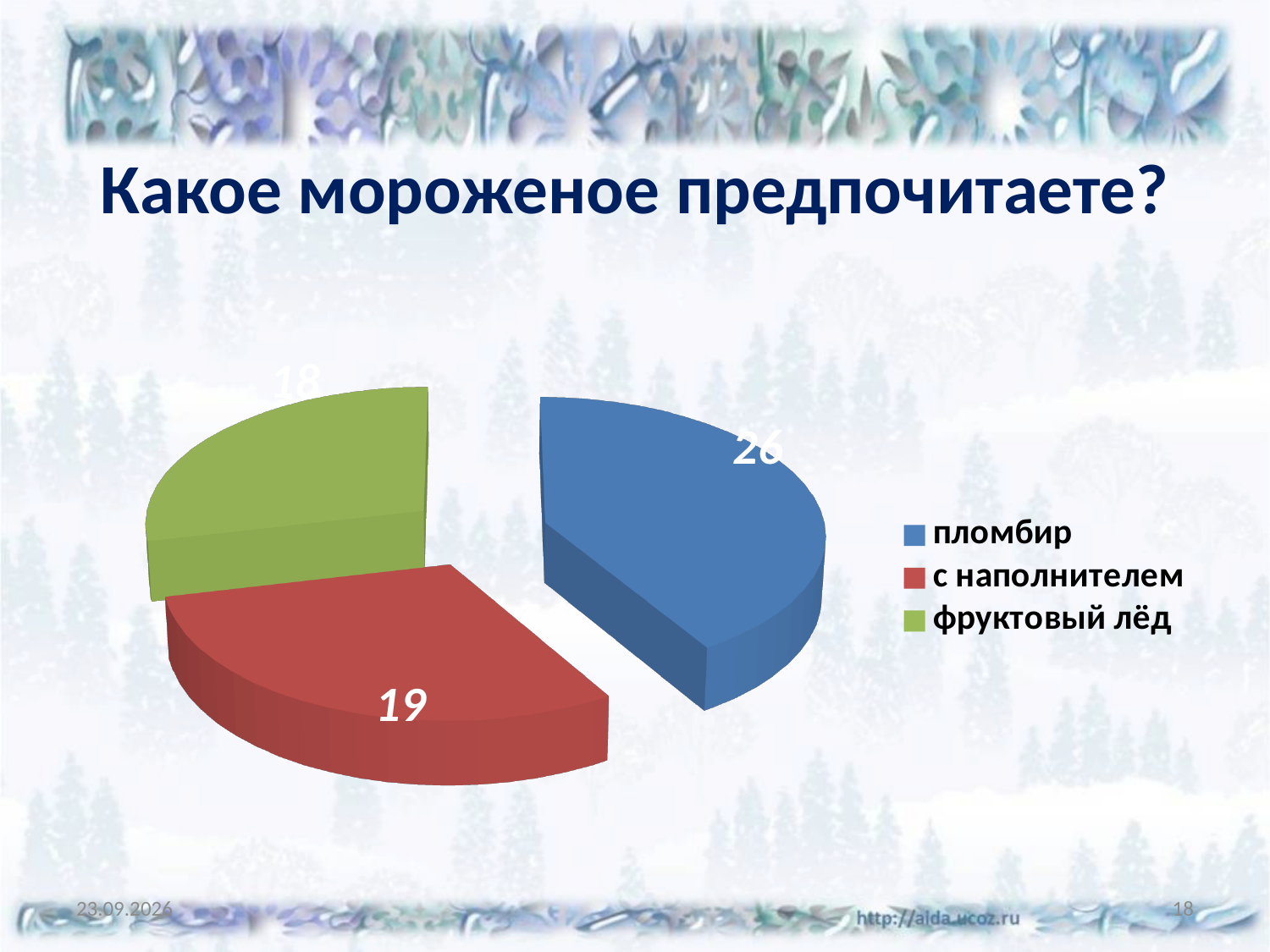
What is the value for фруктовый лёд in the pie chart? 18 What is the difference between the values for с наполнителем and фруктовый лёд? 1 Which is larger, the value for пломбир or the value for с наполнителем? пломбир What is the value for с наполнителем in the pie chart? 19 What is the value for пломбир in the pie chart? 26 What is the difference between the values for пломбир and фруктовый лёд? 8 What kind of chart is shown on the slide? pie chart How many categories are shown in the pie chart? 3 Which category has the largest slice in the pie chart? пломбир What is the total of all the slices in the pie chart? 63 What is the title of the chart on the slide? Какое мороженое предпочитаете? Which category has the smallest slice in the pie chart? фруктовый лёд